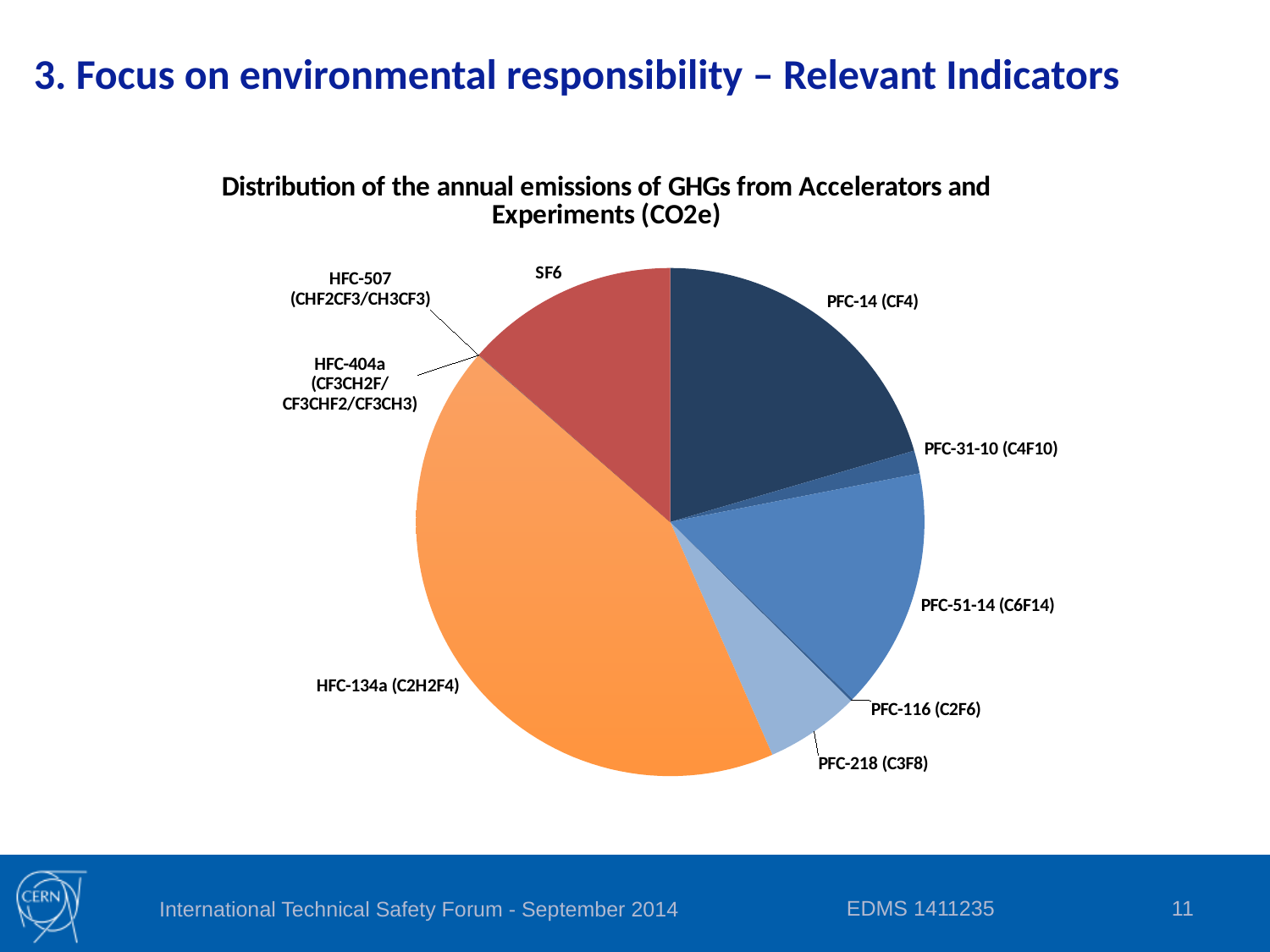
What colour is the HFC-134a (C2H2F4) slice? Orange What is the title of the chart? Distribution of the annual emissions of GHGs from Accelerators and Experiments (CO2e) What kind of chart is shown on the slide? Pie chart Which slice is larger, HFC-134a (C2H2F4) or PFC-14 (CF4)? HFC-134a (C2H2F4) Which slice is larger, PFC-14 (CF4) or PFC-218 (C3F8)? PFC-14 (CF4) Which slice is larger, HFC-134a (C2H2F4) or SF6? HFC-134a (C2H2F4) Which gas has the largest slice of the pie? HFC-134a (C2H2F4) How many gas categories are labelled on the pie chart? 9